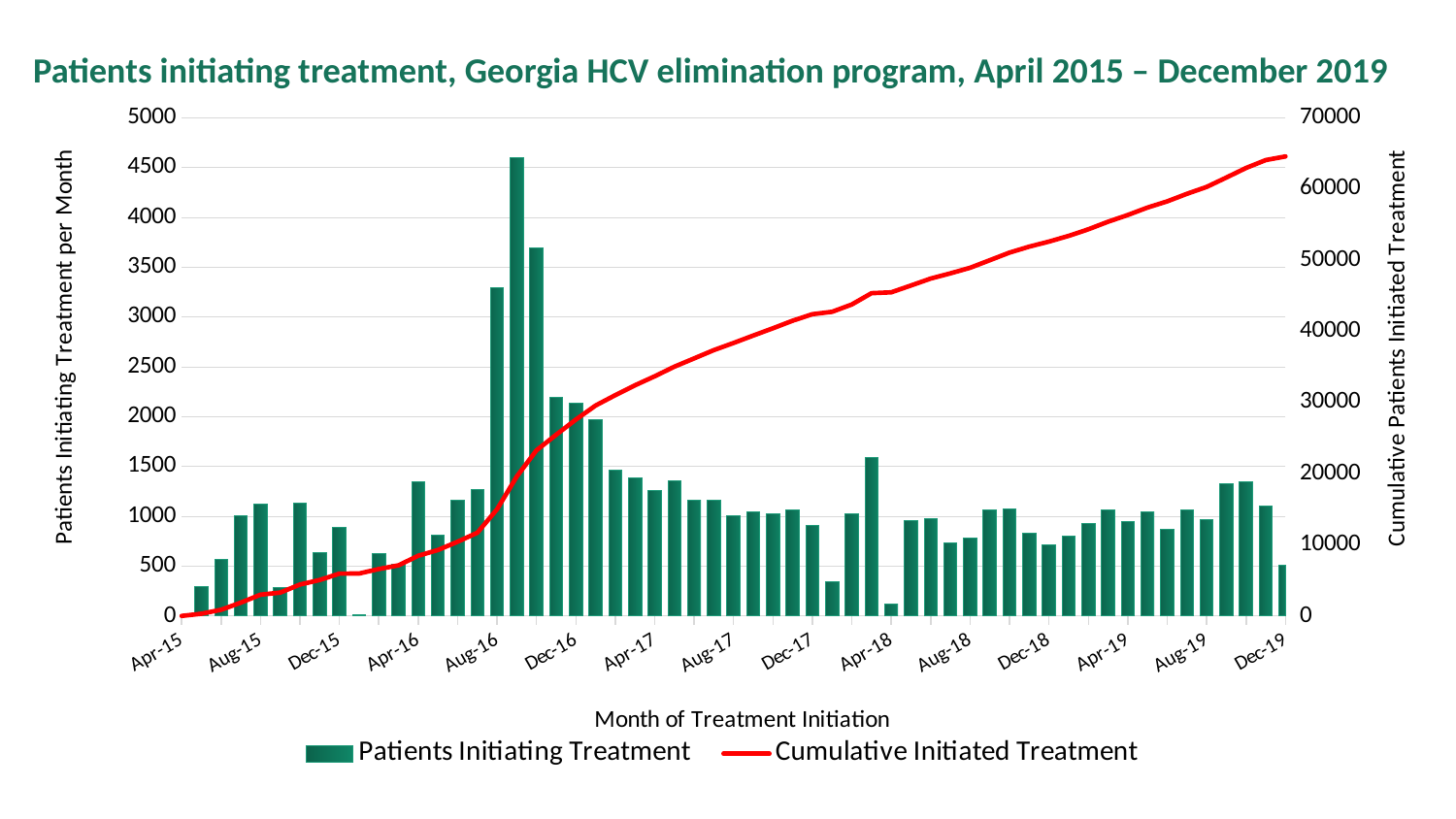
Is the cumulative number of patients initiated on treatment at Dec-19 greater or less than 60000? greater Is the number of patients initiating treatment in Dec-19 greater or less than 1000? less Does the Cumulative Initiated Treatment line rise or fall from Apr-15 to Dec-19? Rises What kind of chart is shown on the slide? A combined bar and line chart Is the number of patients initiating treatment in Dec-16 greater or less than 2000? greater What are the two series named in the legend? Patients Initiating Treatment and Cumulative Initiated Treatment Which month has the larger number of patients initiating treatment, Dec-16 or Dec-19? Dec-16 What is the title of the left vertical axis? Patients Initiating Treatment per Month How many series does the legend list? 2